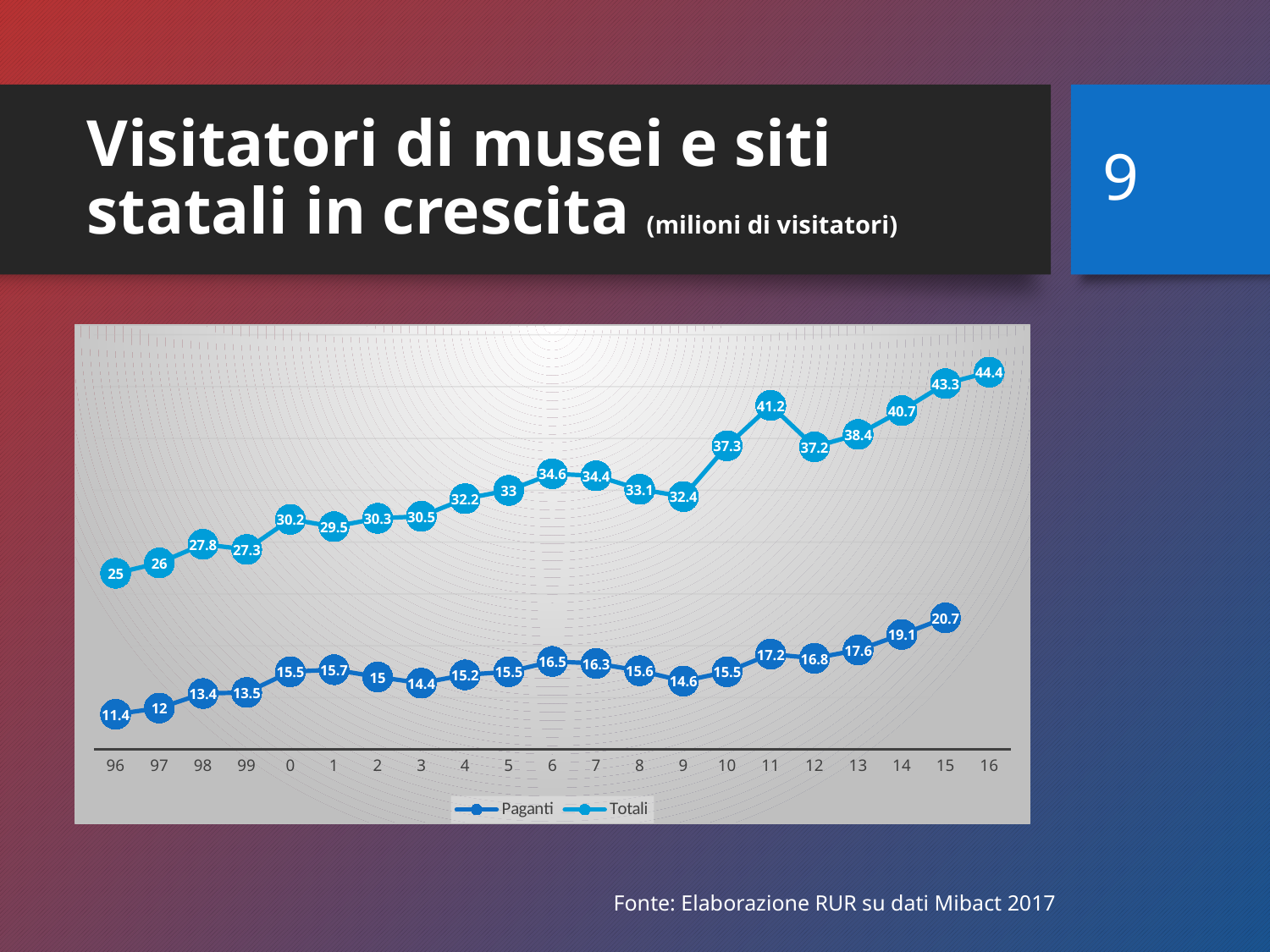
What is the Paganti value for 6? 16.5 What is the difference between the Totali value for 11 and the Totali value for 12? 4 What is the Totali value for 11? 41.2 Which year has the lowest Totali value? 96 Which is larger, the Totali value for 10 or the Totali value for 9? 10 How many points are plotted on the Totali line? 21 What is the Paganti value for 96? 11.4 What type of chart is shown on the slide? line chart Which year has the highest Paganti value? 15 How many series does the legend list? 2 What is the Totali value for 16? 44.4 What are the names of the two series in the legend? Paganti and Totali